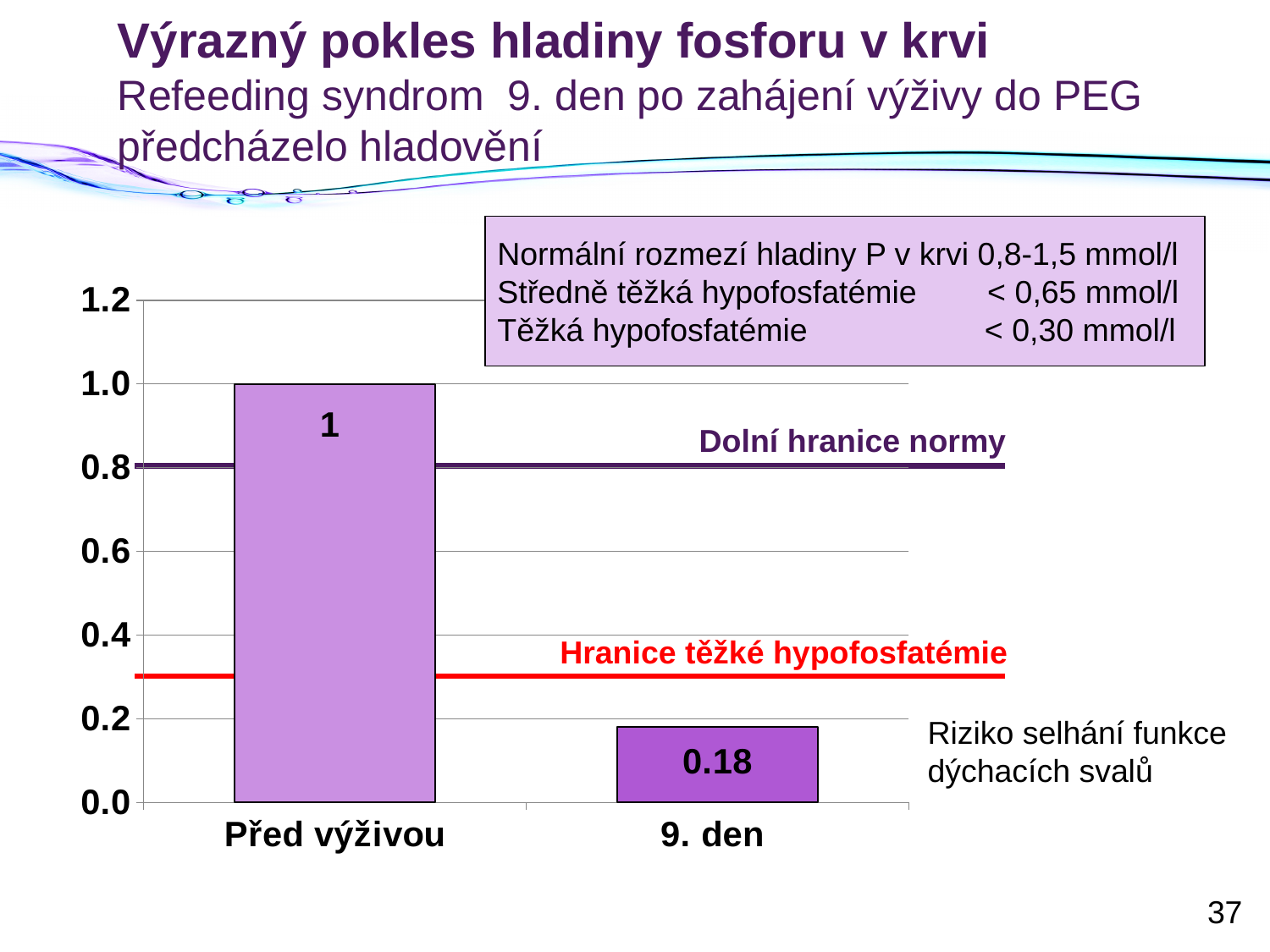
Is the value for "9. den" greater or less than 0.2? less Which category has the highest value? Před výživou What is the difference between the values for "Před výživou" and "9. den"? 0.82 Which is larger, the value for "Před výživou" or the value for "9. den"? Před výživou Is the value for "Před výživou" greater or less than 0.8? greater What is the label of the red horizontal line on the chart? Hranice těžké hypofosfatémie Which category has the lowest value? 9. den What is the value for "9. den"? 0.18 Do the values rise or fall from "Před výživou" to "9. den"? fall How many categories are shown on the x axis? 2 What kind of chart is shown on the slide? bar chart What is the value for "Před výživou"? 1